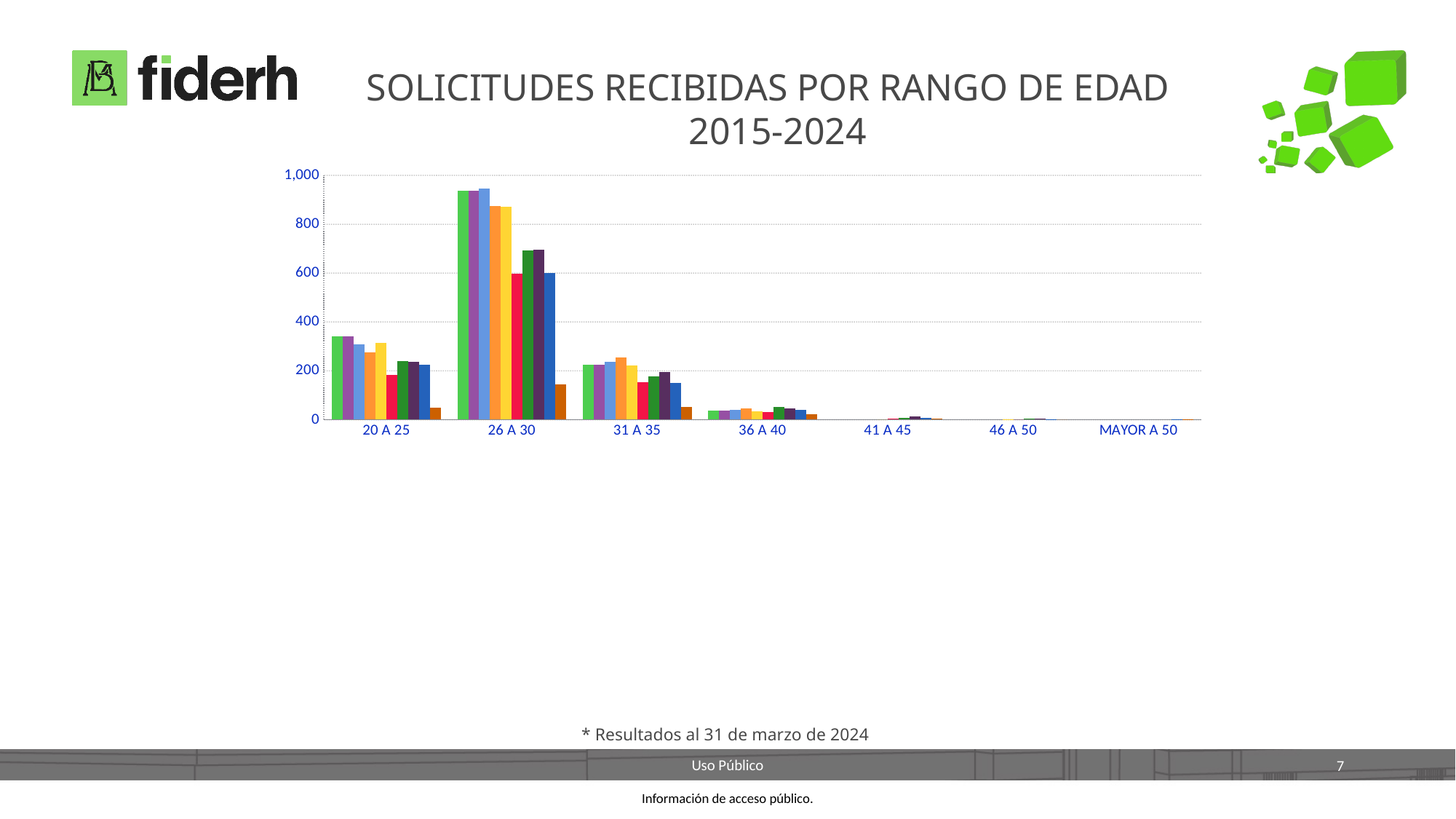
What type of chart is shown on the slide? bar chart Is the tallest bar in the 31 A 35 group greater or less than 400? less Do the bar heights rise or fall moving from 26 A 30 to MAYOR A 50 along the x axis? fall What is the title of the chart? SOLICITUDES RECIBIDAS POR RANGO DE EDAD 2015-2024 Is the tallest bar in the 26 A 30 group greater or less than 800? greater Is the tallest bar in the 36 A 40 group greater or less than 200? less How many age-range categories are shown on the x axis? 7 What is the highest value labelled on the y axis? 1,000 Which age range has taller bars, 20 A 25 or 36 A 40? 20 A 25 Which age range has taller bars, 26 A 30 or 31 A 35? 26 A 30 Which age range has the highest bars? 26 A 30